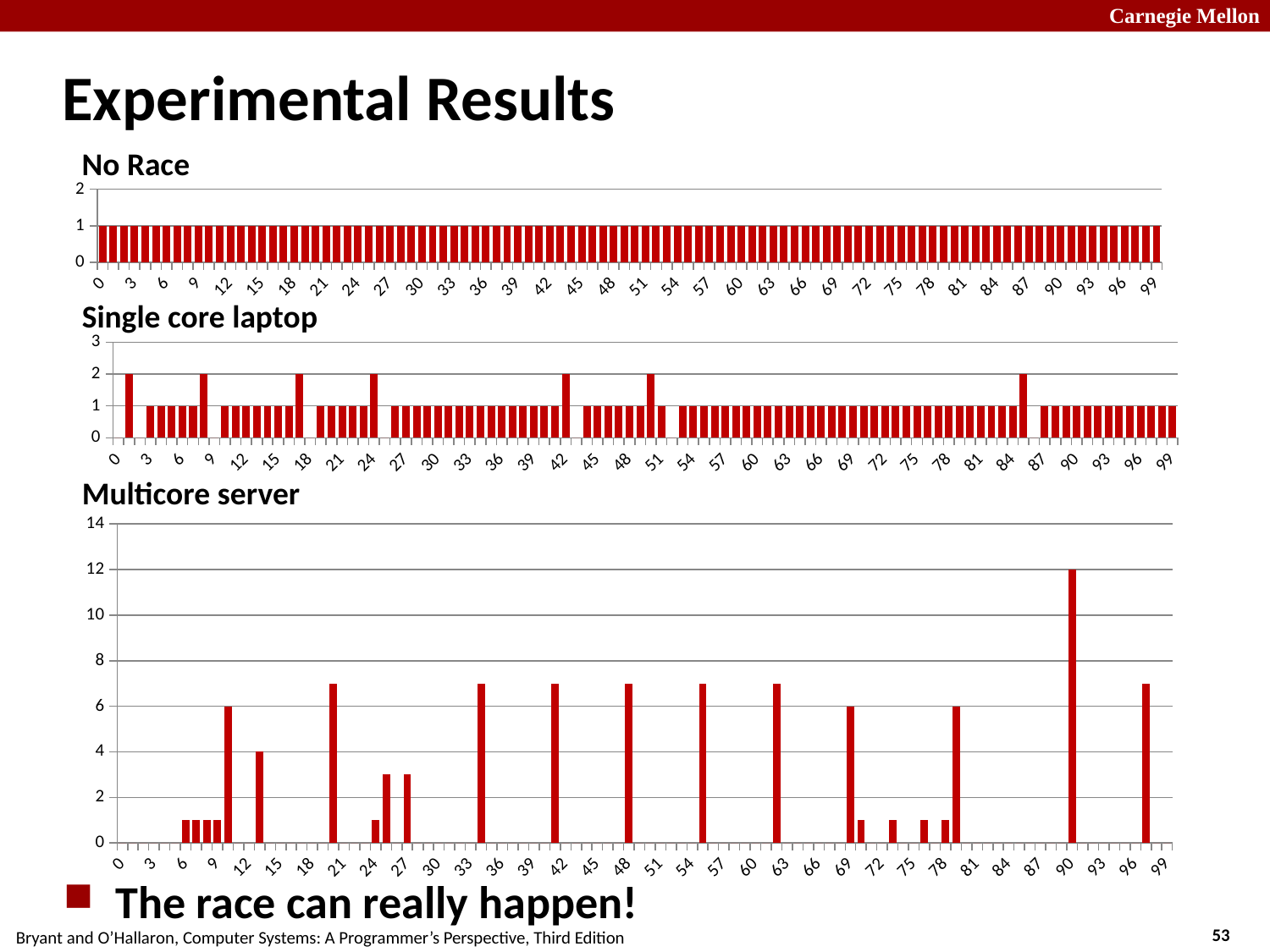
In the 'Single core laptop' chart, is the bar at x = 1 greater or less than 1? greater In the 'Multicore server' chart, which is larger: the bar at x = 90 or the bar at x = 97? the bar at x = 90 In the 'Multicore server' chart, is the bar at x = 90 greater or less than 8? greater How many charts are shown on the slide? 3 In the 'No Race' chart, what value do all the bars reach? 1 In the 'Multicore server' chart, is the bar at x = 90 greater or less than 10? greater In the 'No Race' chart, what is the highest value shown on the y axis? 2 In the 'Single core laptop' chart, what is the highest value any bar reaches? 2 In the 'Multicore server' chart, what is the highest value shown on the y axis? 14 In the 'Multicore server' chart, at which x value is the tallest bar? 90 In the 'Multicore server' chart, what value does the tallest bar reach? 12 What kind of chart is the 'Multicore server' chart? bar chart